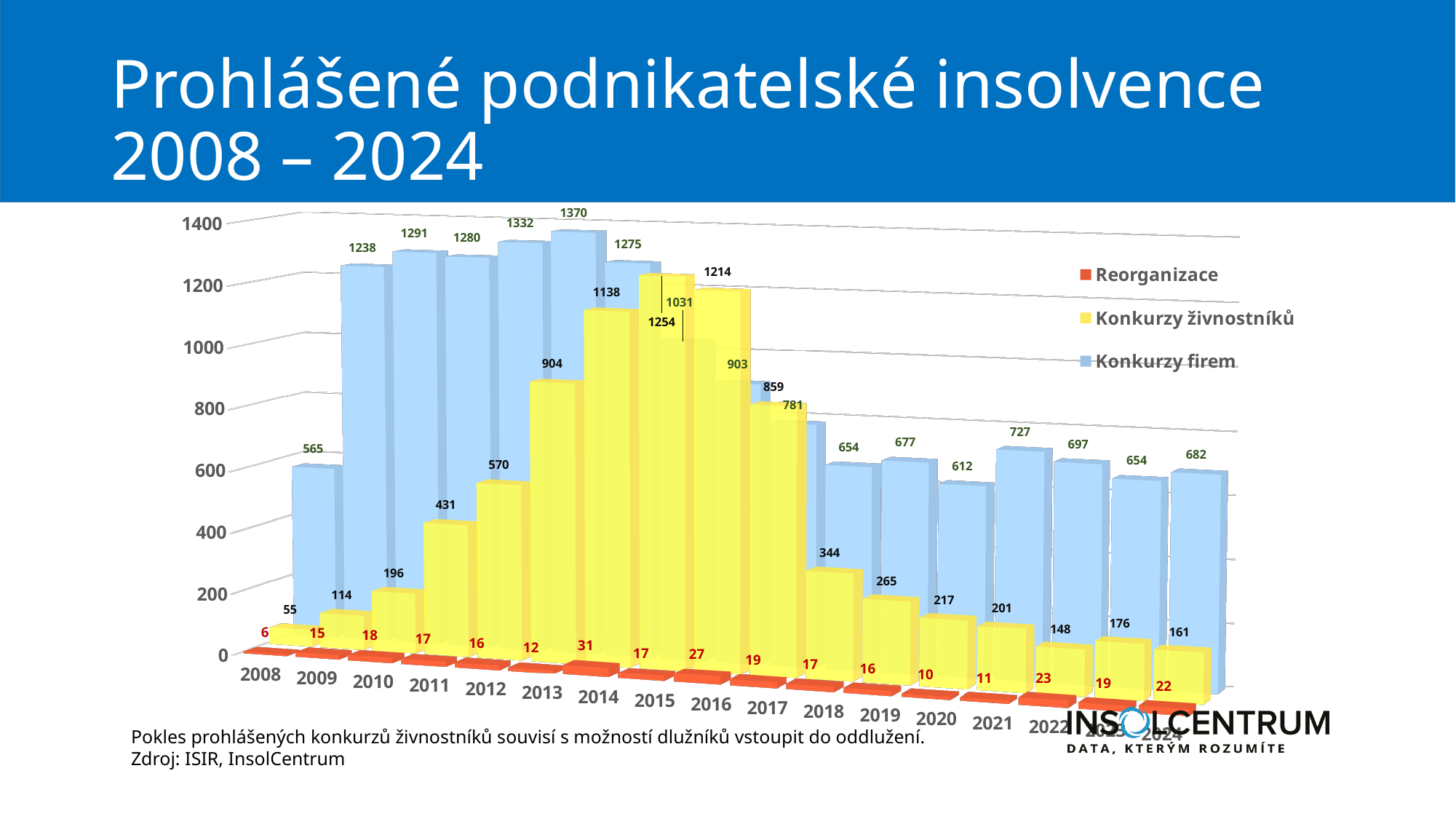
What is the value of Reorganizace for 2014? 31 In which year is Konkurzy firem highest? 2013 What is the value of Konkurzy firem for 2013? 1370 Does Konkurzy živnostníků rise or fall from 2008 to 2015? Rise Which is larger in 2016: Konkurzy živnostníků or Konkurzy firem? Konkurzy živnostníků What is the difference between Konkurzy firem in 2009 and in 2008? 673 How many series does the legend list? 3 Which colour represents Reorganizace in the legend? Red In which year is Reorganizace lowest? 2008 What kind of chart is shown on the slide? Bar chart How many years are shown on the x axis? 17 What is the value of Konkurzy živnostníků for 2015? 1254